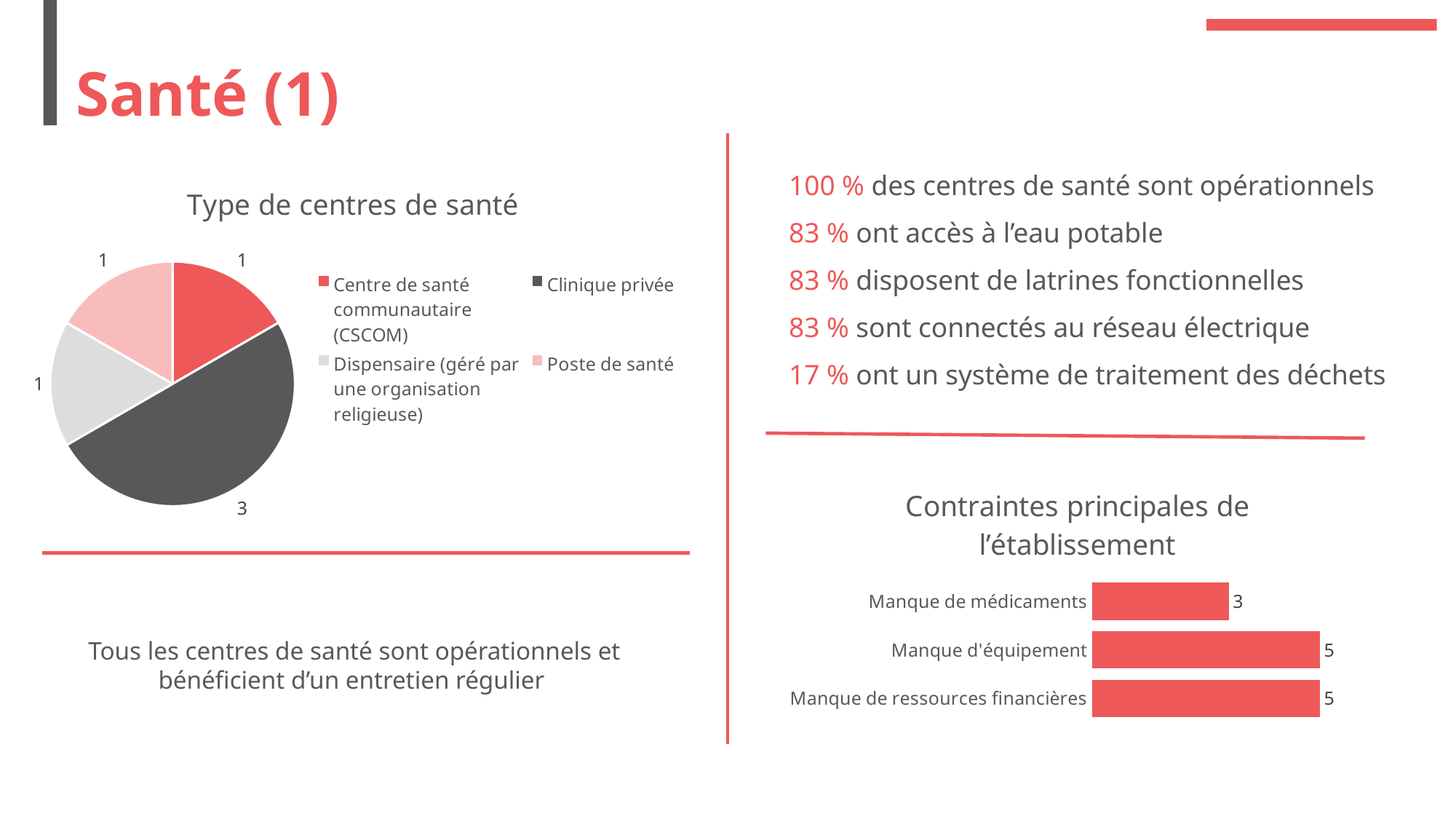
In the 'Type de centres de santé' chart, what share of the pie does Clinique privée represent? 50% In the 'Type de centres de santé' chart, what is the value for Poste de santé? 1 In the 'Type de centres de santé' chart, which category has the largest slice? Clinique privée In the 'Type de centres de santé' chart, what is the difference between Clinique privée and Centre de santé communautaire (CSCOM)? 2 In the 'Type de centres de santé' chart, how many categories does the legend list? 4 In the 'Type de centres de santé' chart, what is the value for Clinique privée? 3 In the 'Contraintes principales de l'établissement' chart, how many categories are shown? 3 In the 'Contraintes principales de l'établissement' chart, which category has the lowest value? Manque de médicaments What kind of chart is 'Type de centres de santé'? Pie chart In the 'Contraintes principales de l'établissement' chart, what is the value for Manque de médicaments? 3 In the 'Contraintes principales de l'établissement' chart, what is the value for Manque d'équipement? 5 What kind of chart is 'Contraintes principales de l'établissement'? Bar chart